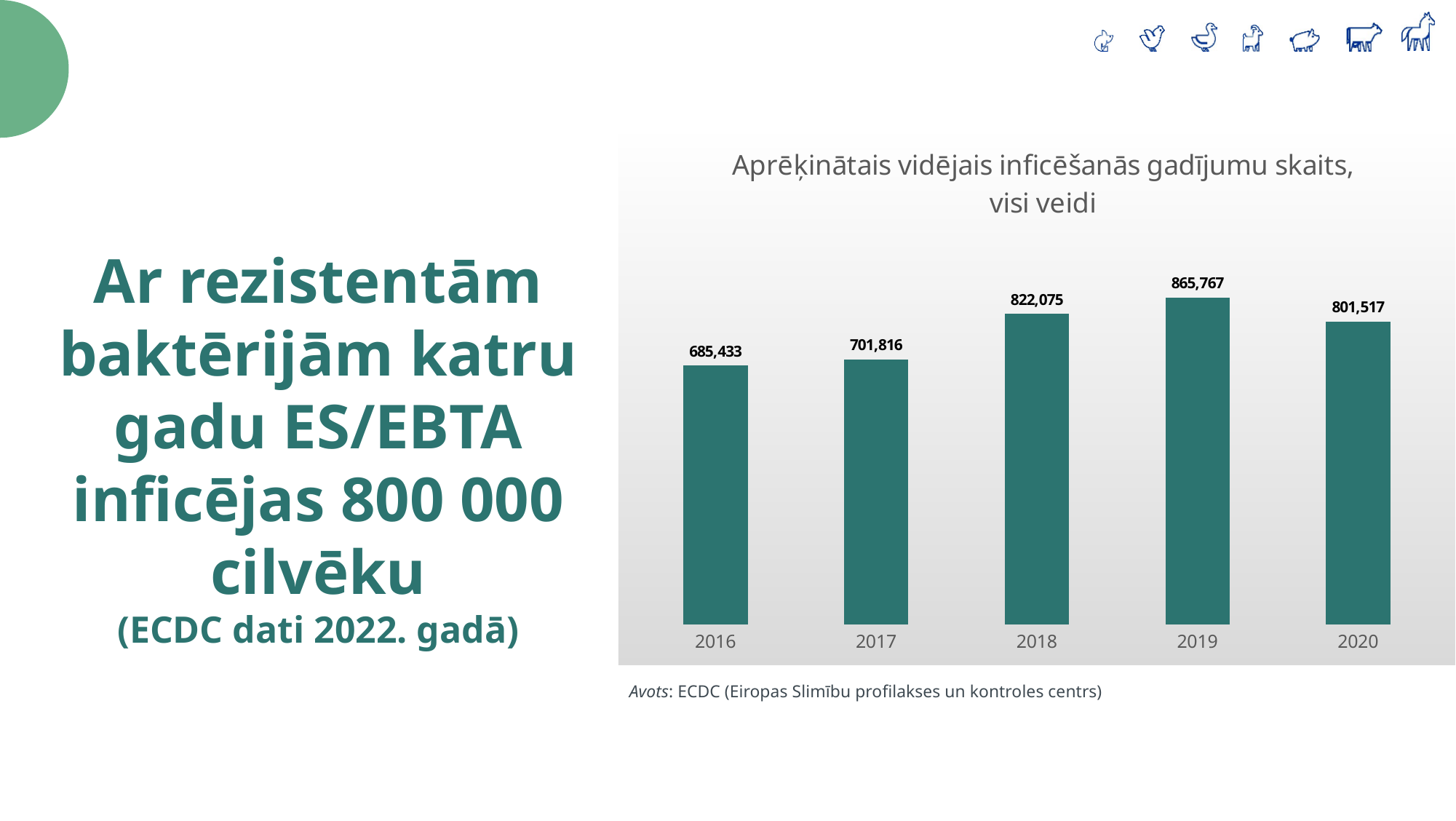
What kind of chart is shown? Bar chart Which year has the highest value? 2019 What is the value for 2016? 685,433 Which year has the lowest value? 2016 Between 2016 and 2019, do the values rise or fall? Rise Which is larger, the value for 2018 or the value for 2020? 2018 What is the title of the chart? Aprēķinātais vidējais inficēšanās gadījumu skaits, visi veidi What is the difference between the values for 2019 and 2018? 43,692 What is the value for 2018? 822,075 What is the value for 2020? 801,517 How many years are shown on the x axis? 5 What is the difference between the values for 2020 and 2016? 116,084